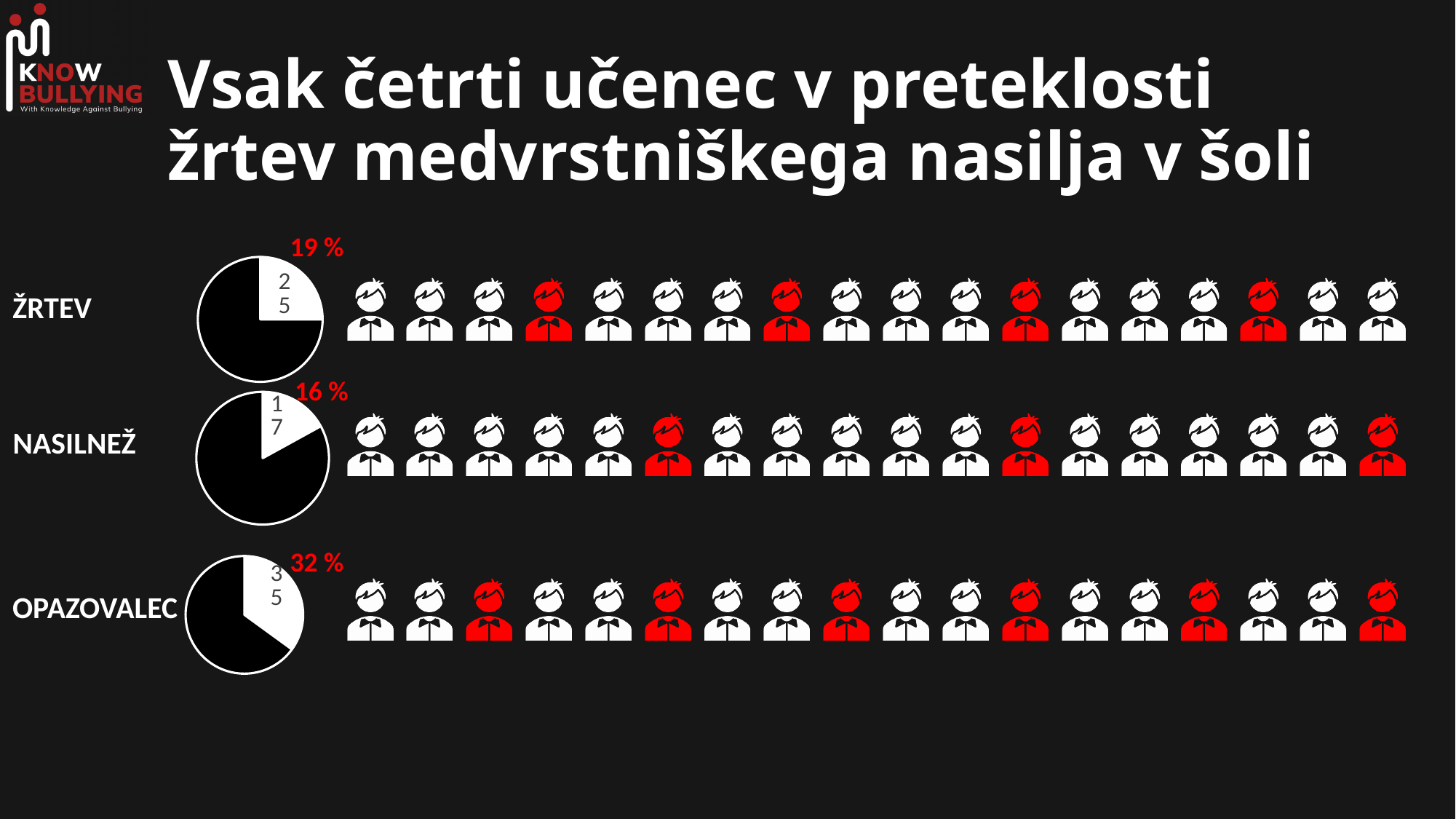
Which category has the highest percentage label: ŽRTEV, NASILNEŽ or OPAZOVALEC? OPAZOVALEC What is the difference between the OPAZOVALEC percentage and the ŽRTEV percentage? 13 % How many red figures are in the OPAZOVALEC row of pictograms? 6 What colour are the highlighted figures in the pictogram rows? red Which category has the lowest percentage label: ŽRTEV, NASILNEŽ or OPAZOVALEC? NASILNEŽ How many pie charts are on the slide? 3 How many red figures are in the ŽRTEV row of pictograms? 4 What percentage is shown next to the OPAZOVALEC pie chart? 32 % Is the percentage for ŽRTEV larger or smaller than the percentage for NASILNEŽ? larger What percentage is shown next to the NASILNEŽ pie chart? 16 % What percentage is shown next to the ŽRTEV pie chart? 19 % What kind of chart is shown to the left of each row of figures? pie chart